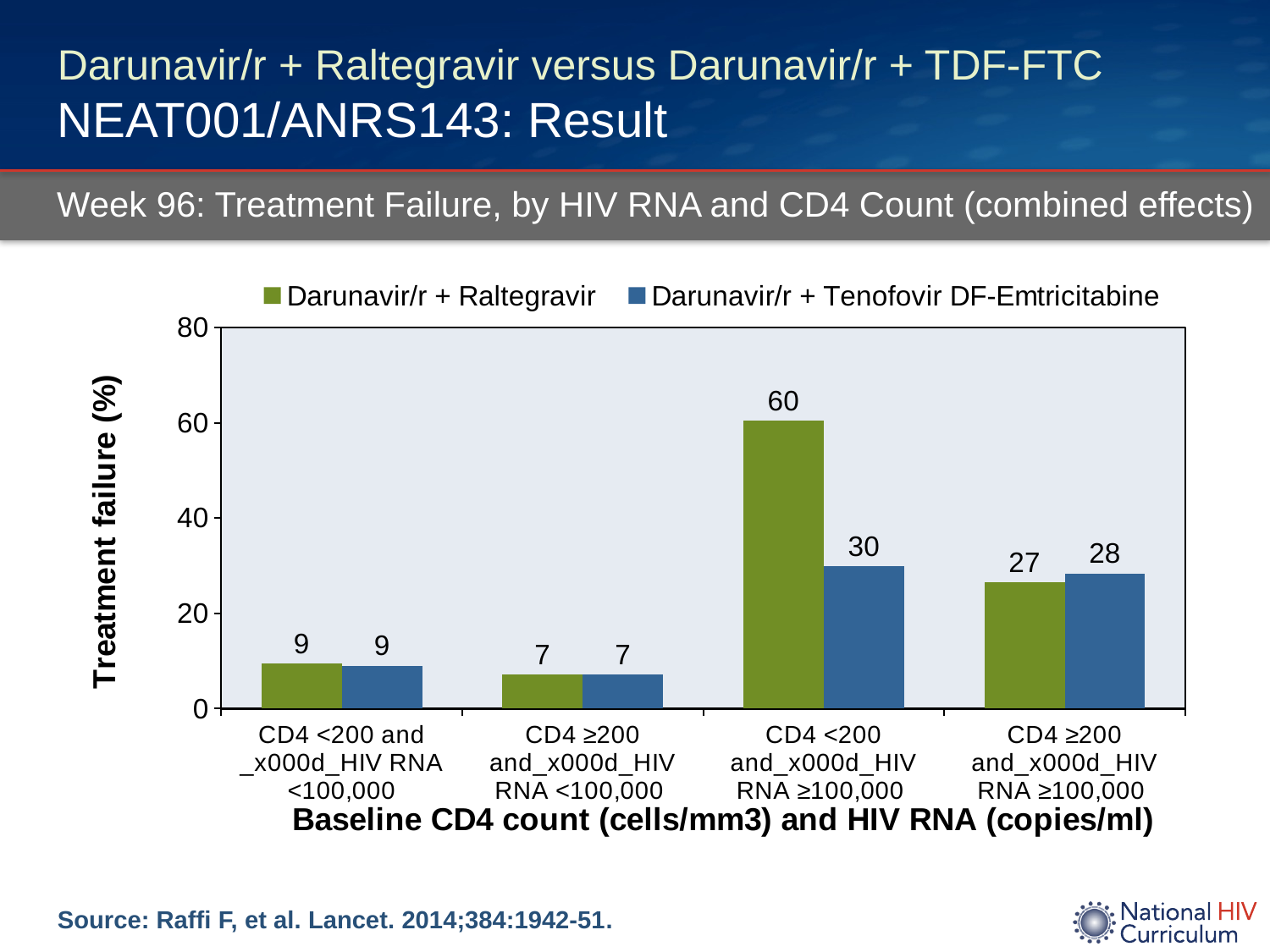
How many series does the legend list? 2 What is the treatment failure percentage for Darunavir/r + Tenofovir DF-Emtricitabine in the CD4 <200 and HIV RNA ≥100,000 group? 30 Which baseline group has the highest treatment failure for Darunavir/r + Raltegravir? CD4 <200 and HIV RNA ≥100,000 What is the treatment failure percentage for Darunavir/r + Raltegravir in the CD4 ≥200 and HIV RNA ≥100,000 group? 27 What is the label of the y axis? Treatment failure (%) What is the difference in treatment failure between Darunavir/r + Raltegravir and Darunavir/r + Tenofovir DF-Emtricitabine in the CD4 <200 and HIV RNA ≥100,000 group? 30 Which baseline group has the lowest treatment failure for Darunavir/r + Tenofovir DF-Emtricitabine? CD4 ≥200 and HIV RNA <100,000 What kind of chart is shown on the slide? Bar chart What is the treatment failure percentage for Darunavir/r + Tenofovir DF-Emtricitabine in the CD4 ≥200 and HIV RNA <100,000 group? 7 What is the treatment failure percentage for Darunavir/r + Raltegravir in the CD4 <200 and HIV RNA ≥100,000 group? 60 In the CD4 ≥200 and HIV RNA ≥100,000 group, which treatment has the higher treatment failure percentage? Darunavir/r + Tenofovir DF-Emtricitabine How many baseline CD4 count and HIV RNA groups are shown on the x axis? 4